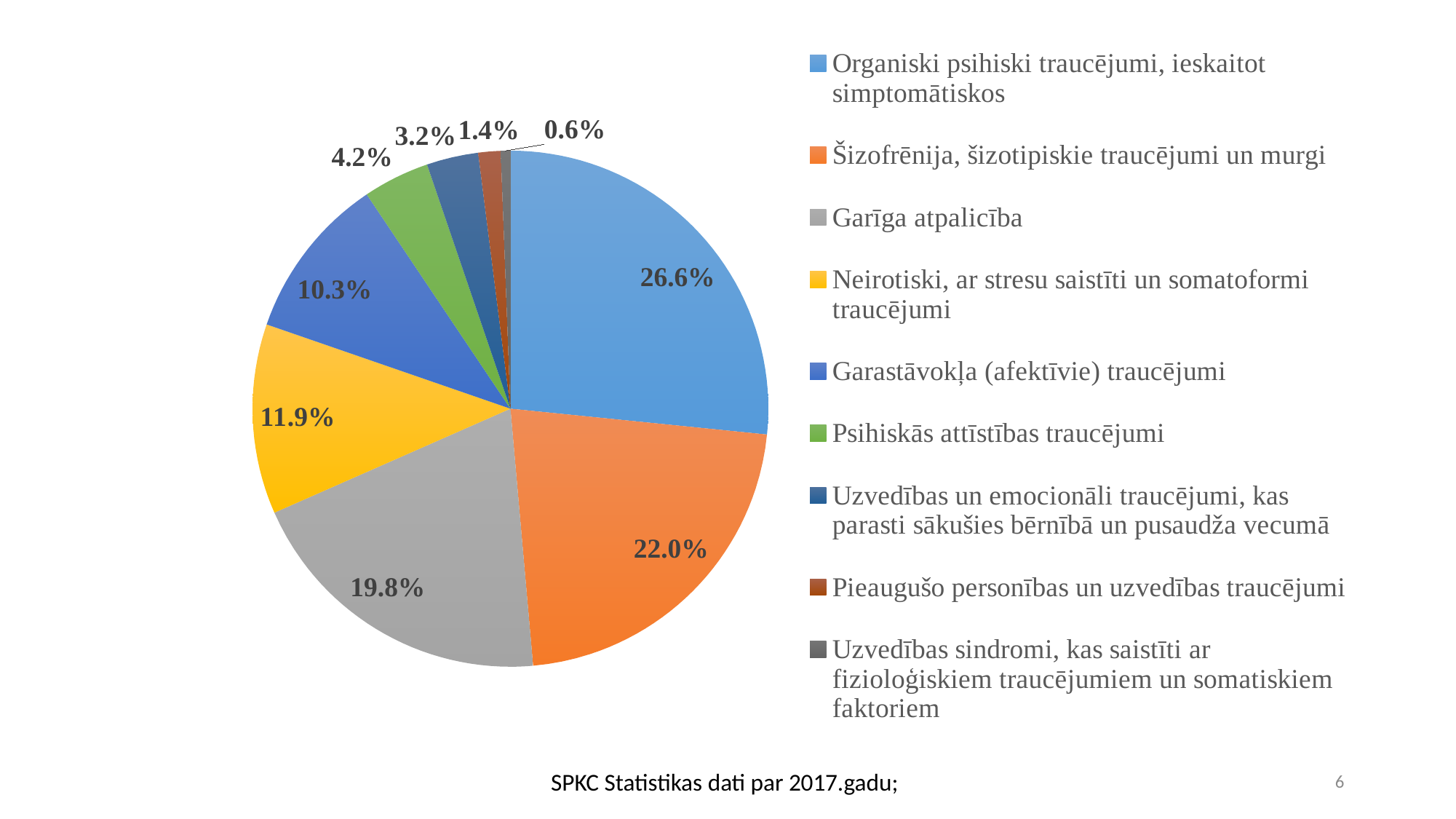
Which category has the largest slice of the pie? Organiski psihiski traucējumi, ieskaitot simptomātiskos What source text is shown below the chart? SPKC Statistikas dati par 2017.gadu; What percentage is shown for Garastāvokļa (afektīvie) traucējumi? 10.3% How many slices does the pie chart have? 9 What is the difference in percentage points between the largest slice (26.6%) and the slice for Šizofrēnija, šizotipiskie traucējumi un murgi (22.0%)? 4.6 What percentage is shown for Šizofrēnija, šizotipiskie traucējumi un murgi? 22.0% Which category has the smallest slice of the pie? Uzvedības sindromi, kas saistīti ar fizioloģiskiem traucējumiem un somatiskiem faktoriem What kind of chart is shown on the slide? pie chart What percentage is shown for Neirotiski, ar stresu saistīti un somatoformi traucējumi? 11.9% What percentage is shown for Uzvedības un emocionāli traucējumi, kas parasti sākušies bērnībā un pusaudža vecumā? 3.2% What share of the pie is labelled for Garīga atpalicība? 19.8% Which is larger: the slice for Psihiskās attīstības traucējumi or the slice for Pieaugušo personības un uzvedības traucējumi? Psihiskās attīstības traucējumi